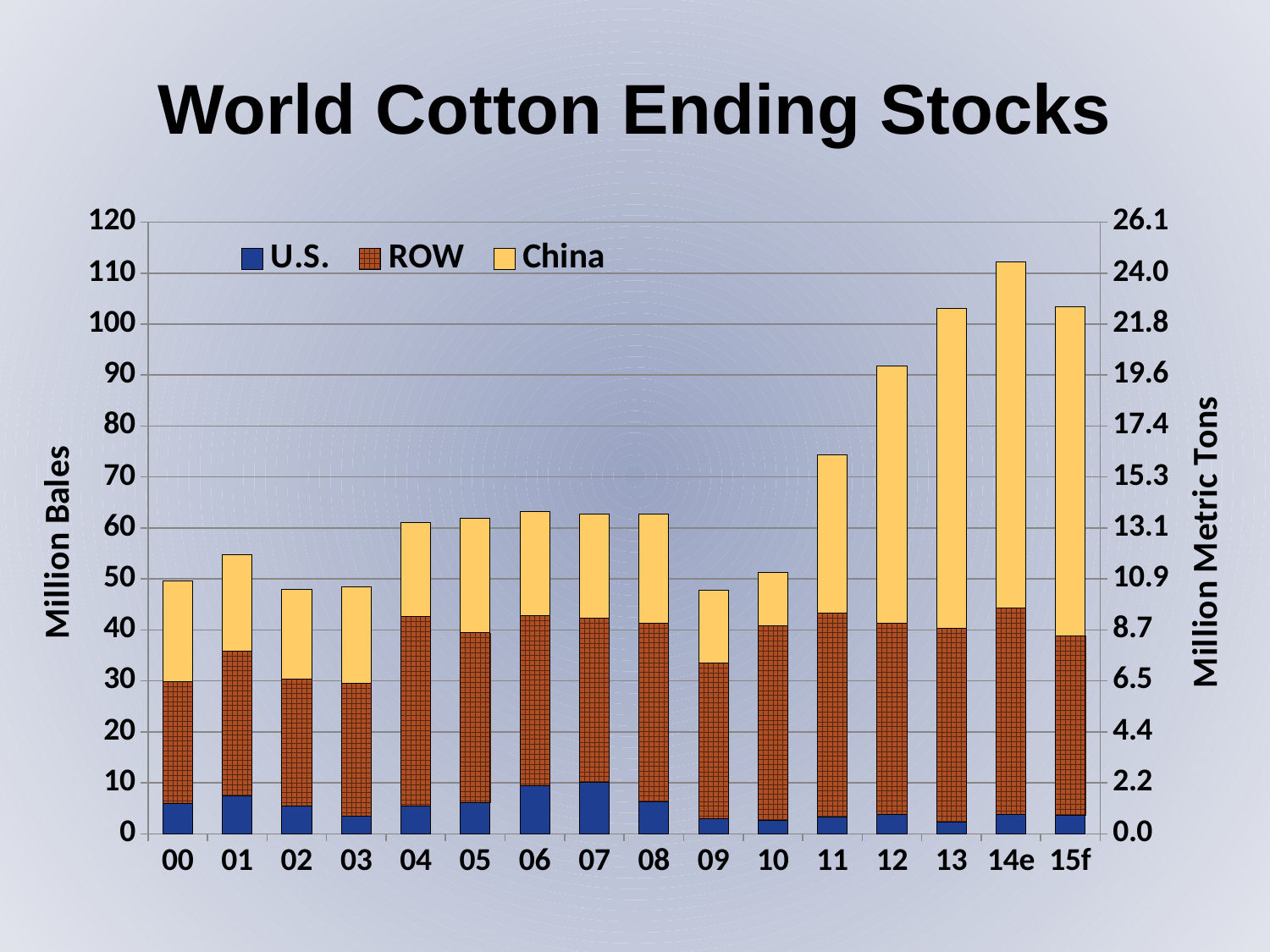
Is the total ending stocks for 12 greater or less than 100 million bales? less How many years (categories) are shown along the x axis? 16 How many series does the legend list? 3 Is the total ending stocks for 09 greater or less than 60 million bales? less What is the label on the right-hand vertical axis? Million Metric Tons Which year has the highest total ending stocks? 14e Is the total ending stocks for 11 greater or less than 70 million bales? greater What kind of chart is shown on the slide? Stacked bar chart Which year has larger total ending stocks, 10 or 11? 11 What is the title of the chart? World Cotton Ending Stocks Do total ending stocks rise or fall from 10 to 14e? rise